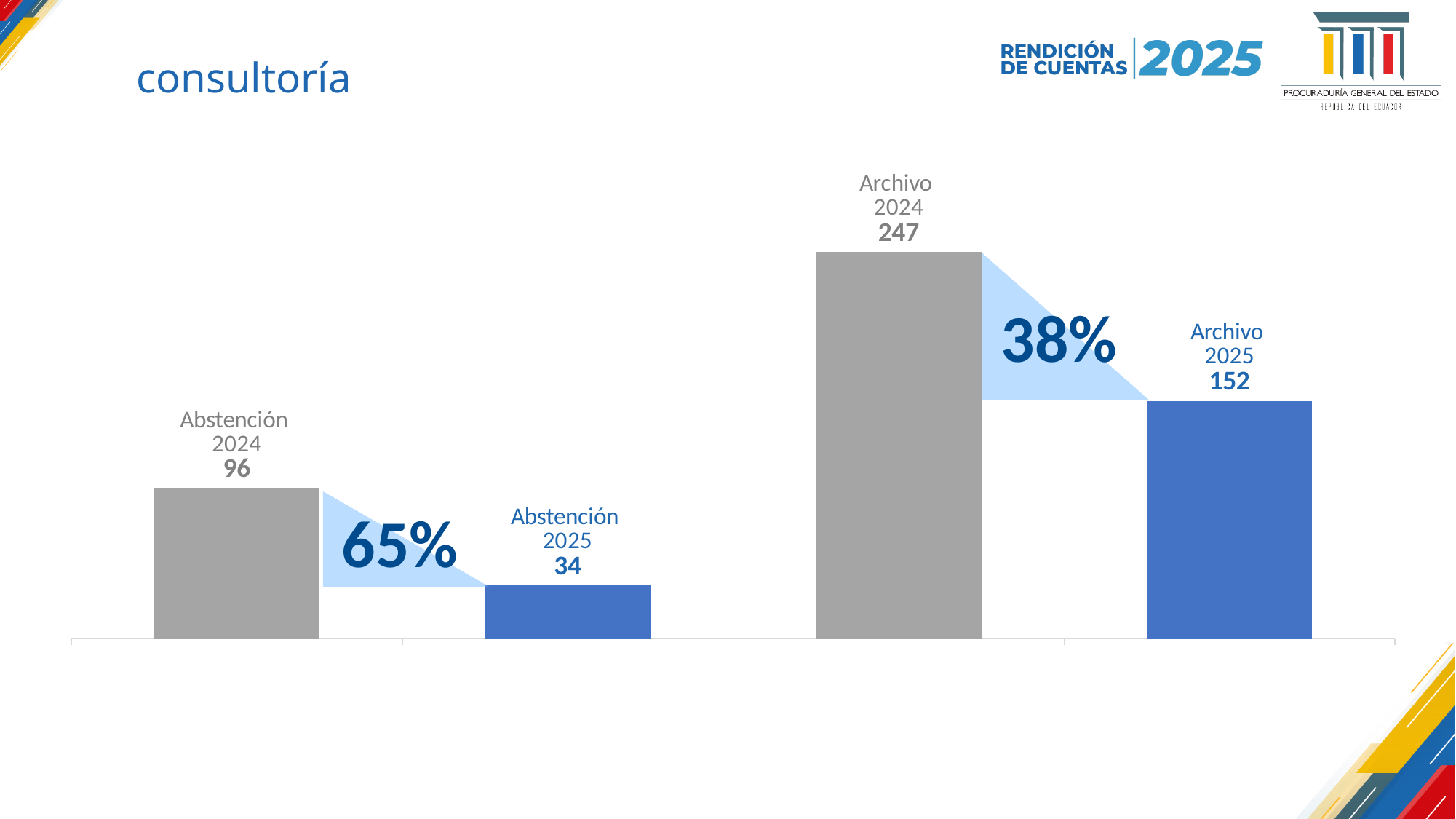
What kind of chart is shown on the slide? Bar chart What is the value for Abstención 2025? 34 How many bars are plotted on the chart? 4 What is the value for Archivo 2024? 247 Which bar has the lowest value? Abstención 2025 What is the difference between Abstención 2024 and Abstención 2025? 62 What percentage decrease is shown between Archivo 2024 and Archivo 2025? 38% Which bar has the highest value? Archivo 2024 What is the difference between Archivo 2024 and Archivo 2025? 95 What is the value for Archivo 2025? 152 Which is larger, Abstención 2024 or Archivo 2025? Archivo 2025 What is the value for Abstención 2024? 96